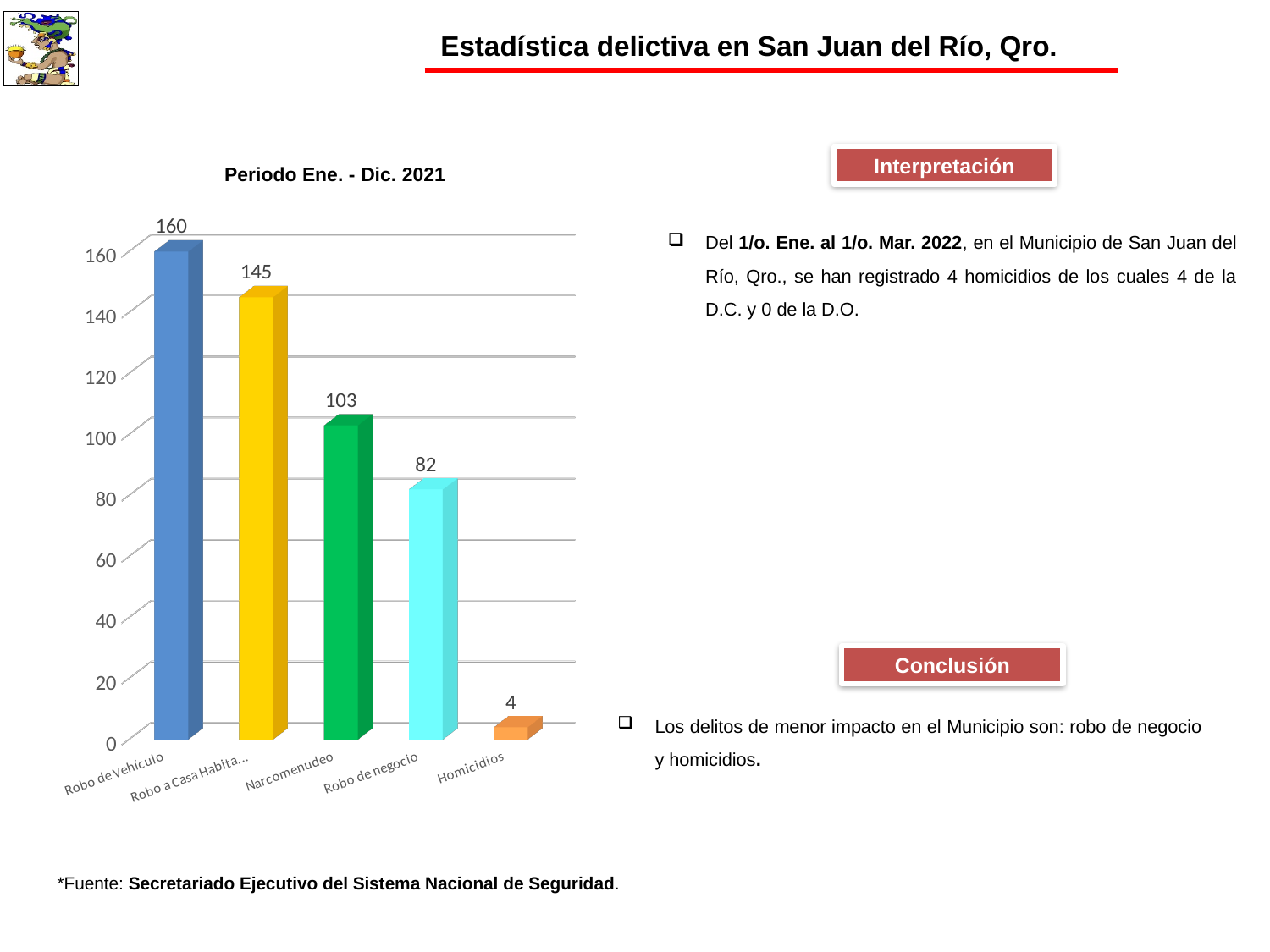
Which category has the highest value? Robo de Vehículo What is the value for Narcomenudeo? 103 What kind of chart is shown on the slide? Bar chart What is the value for Homicidios? 4 Which is larger, the value for Narcomenudeo or the value for Robo de negocio? Narcomenudeo What is the difference between the values for Robo de negocio and Homicidios? 78 Which category has the lowest value? Homicidios What is the title of the chart? Periodo Ene. - Dic. 2021 What is the value for Robo de Vehículo? 160 How many categories are shown in the chart? 5 What is the difference between the values for Robo de Vehículo and Narcomenudeo? 57 What is the value for Robo de negocio? 82